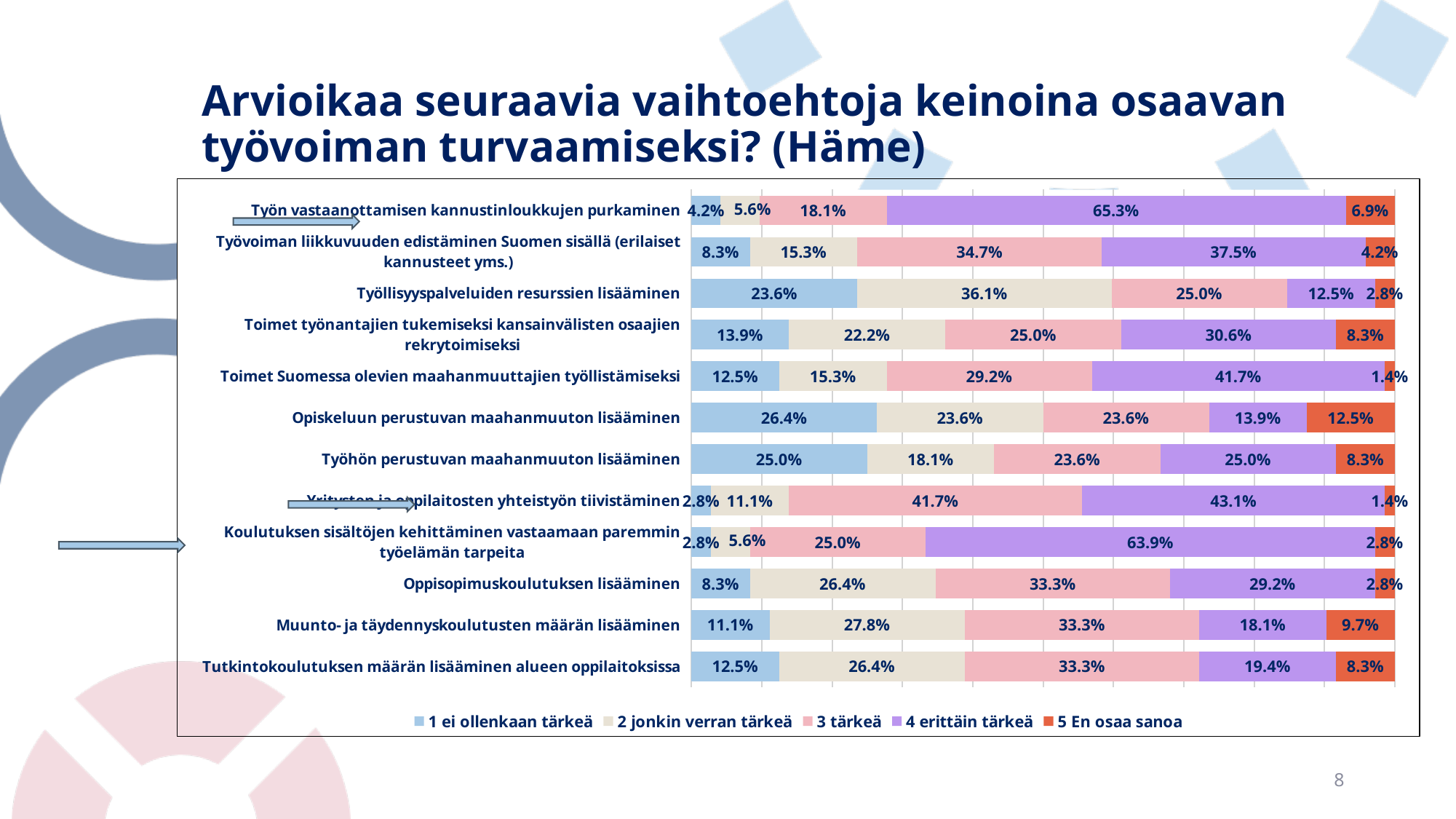
Which legend entry is shown in purple? 4 erittäin tärkeä What is the value of "2 jonkin verran tärkeä" for "Työllisyyspalveluiden resurssien lisääminen"? 36.1% How many series does the legend list? 5 How many categories (options) are plotted in the chart? 12 What is the value of "4 erittäin tärkeä" for "Työn vastaanottamisen kannustinloukkujen purkaminen"? 65.3% What is the value of "5 En osaa sanoa" for "Opiskeluun perustuvan maahanmuuton lisääminen"? 12.5% What is the value of "3 tärkeä" for "Yritysten ja oppilaitosten yhteistyön tiivistäminen"? 41.7% What is the difference between the "4 erittäin tärkeä" values for "Koulutuksen sisältöjen kehittäminen vastaamaan paremmin työelämän tarpeita" and "Oppisopimuskoulutuksen lisääminen"? 34.7% Which category has the highest value for "4 erittäin tärkeä"? Työn vastaanottamisen kannustinloukkujen purkaminen Which category has the lowest value for "4 erittäin tärkeä"? Työllisyyspalveluiden resurssien lisääminen Which is larger: the "1 ei ollenkaan tärkeä" value for "Opiskeluun perustuvan maahanmuuton lisääminen" or for "Muunto- ja täydennyskoulutusten määrän lisääminen"? Opiskeluun perustuvan maahanmuuton lisääminen What kind of chart is shown on the slide? Stacked bar chart